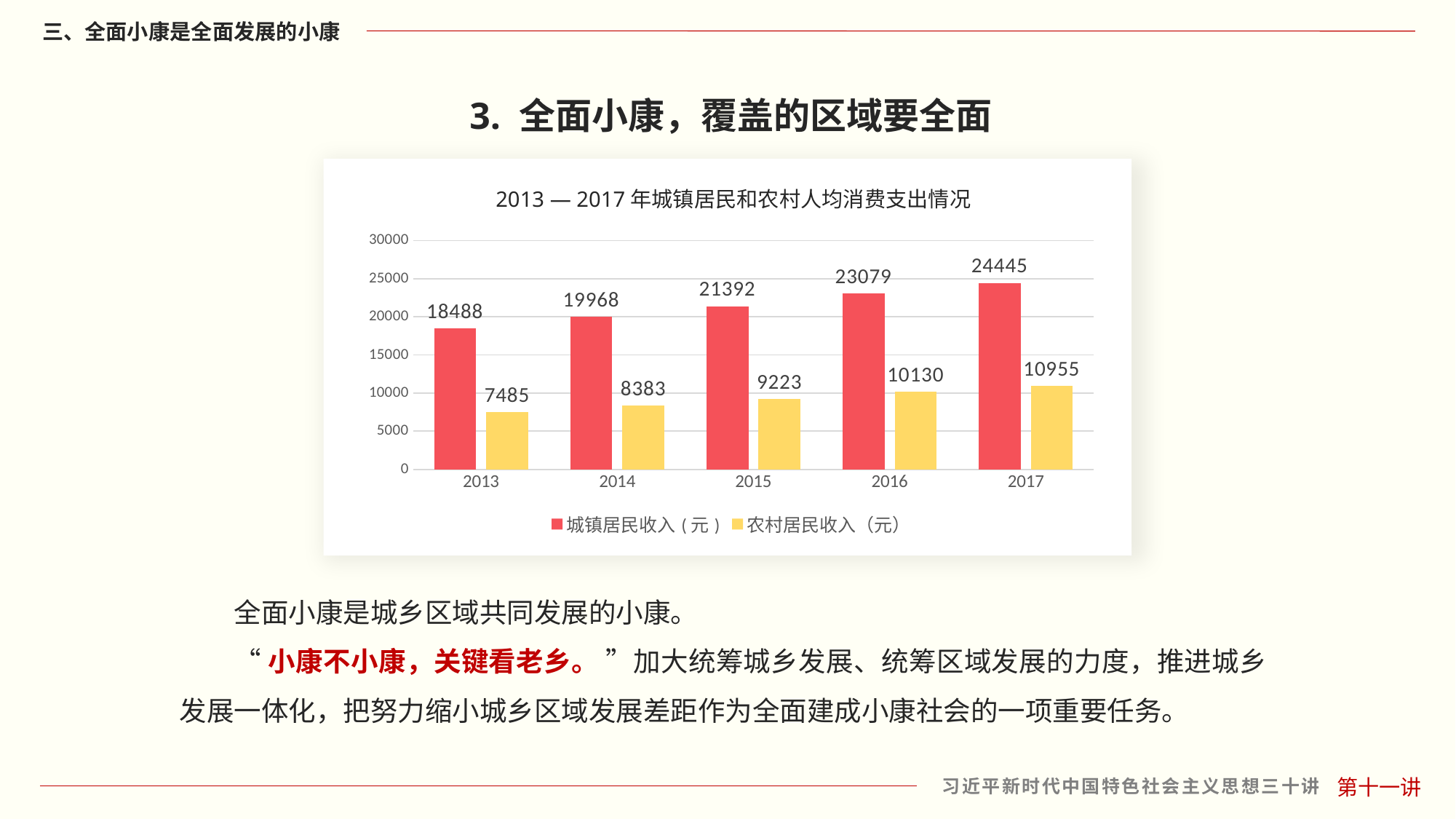
How many series does the legend list? 2 What kind of chart is shown on the slide? bar chart How many years are shown on the x axis? 5 Which is larger: 农村居民收入（元） in 2016 or 城镇居民收入（元） in 2013? 城镇居民收入（元） in 2013 What is the value for 农村居民收入（元） in 2017? 10955 What is the value for 农村居民收入（元） in 2013? 7485 Which year has the lowest value for 农村居民收入（元）? 2013 What is the difference between 城镇居民收入（元） and 农村居民收入（元） in 2017? 13490 What is the value for 城镇居民收入（元） in 2015? 21392 What is the difference between the 城镇居民收入（元） values for 2014 and 2013? 1480 Do the values for 农村居民收入（元） rise or fall from 2013 to 2017? rise Which year has the highest value for 城镇居民收入（元）? 2017